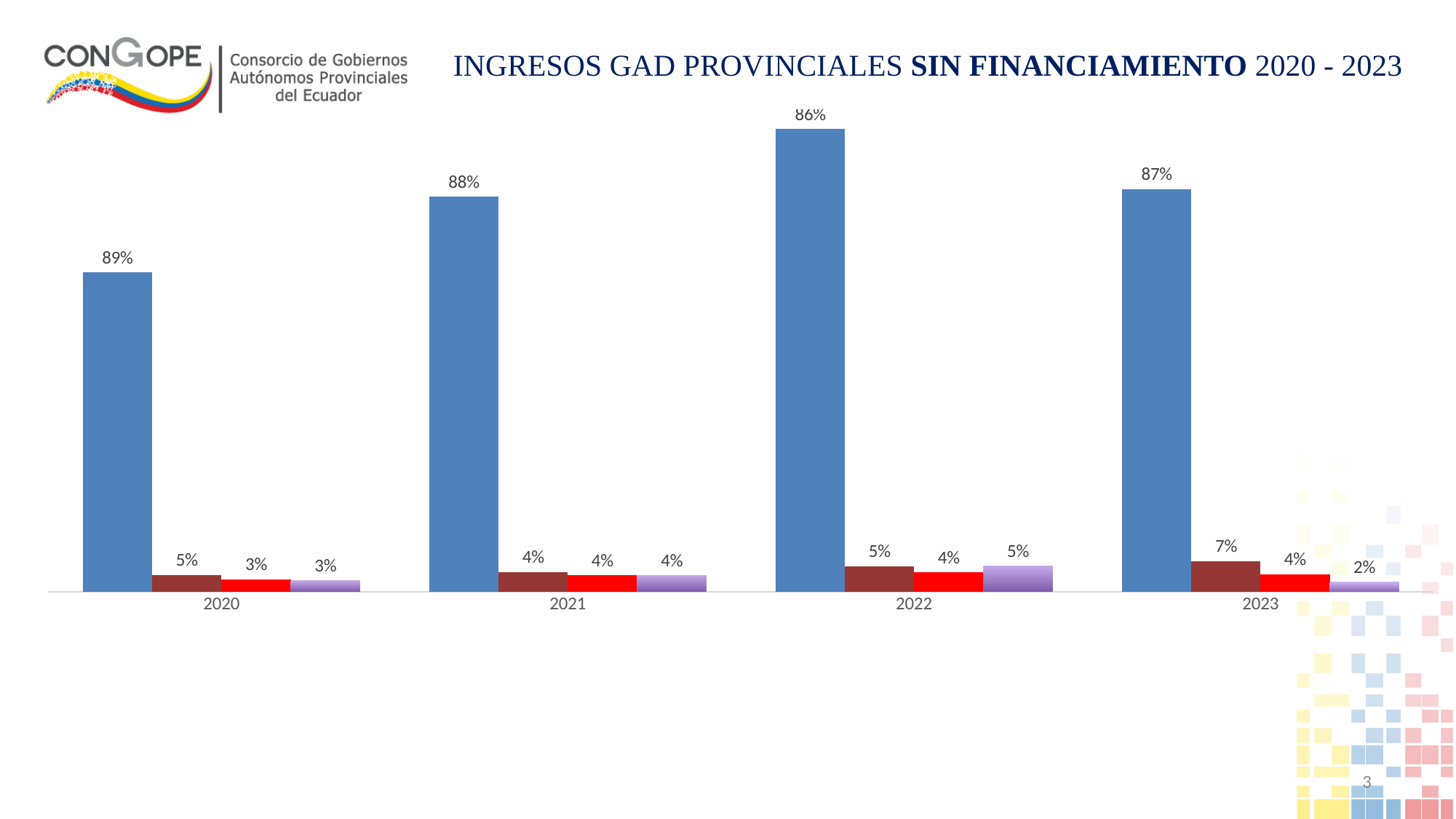
What is the value of the purple bar for 2023? 2% Does the blue bar rise or fall from 2020 to 2022? Rise What is the value of the blue bar for 2020? 89% How many years are shown on the x axis? 4 What is the title of the slide's chart? INGRESOS GAD PROVINCIALES SIN FINANCIAMIENTO 2020 - 2023 Which is larger, the dark red bar for 2023 or the dark red bar for 2021? 2023 In which year is the blue bar highest? 2022 In which year is the blue bar lowest? 2020 What is the difference between the blue bar values for 2020 and 2022? 3% What is the value of the dark red bar for 2023? 7% What kind of chart is shown on the slide? Bar chart What is the value of the blue bar for 2022? 86%